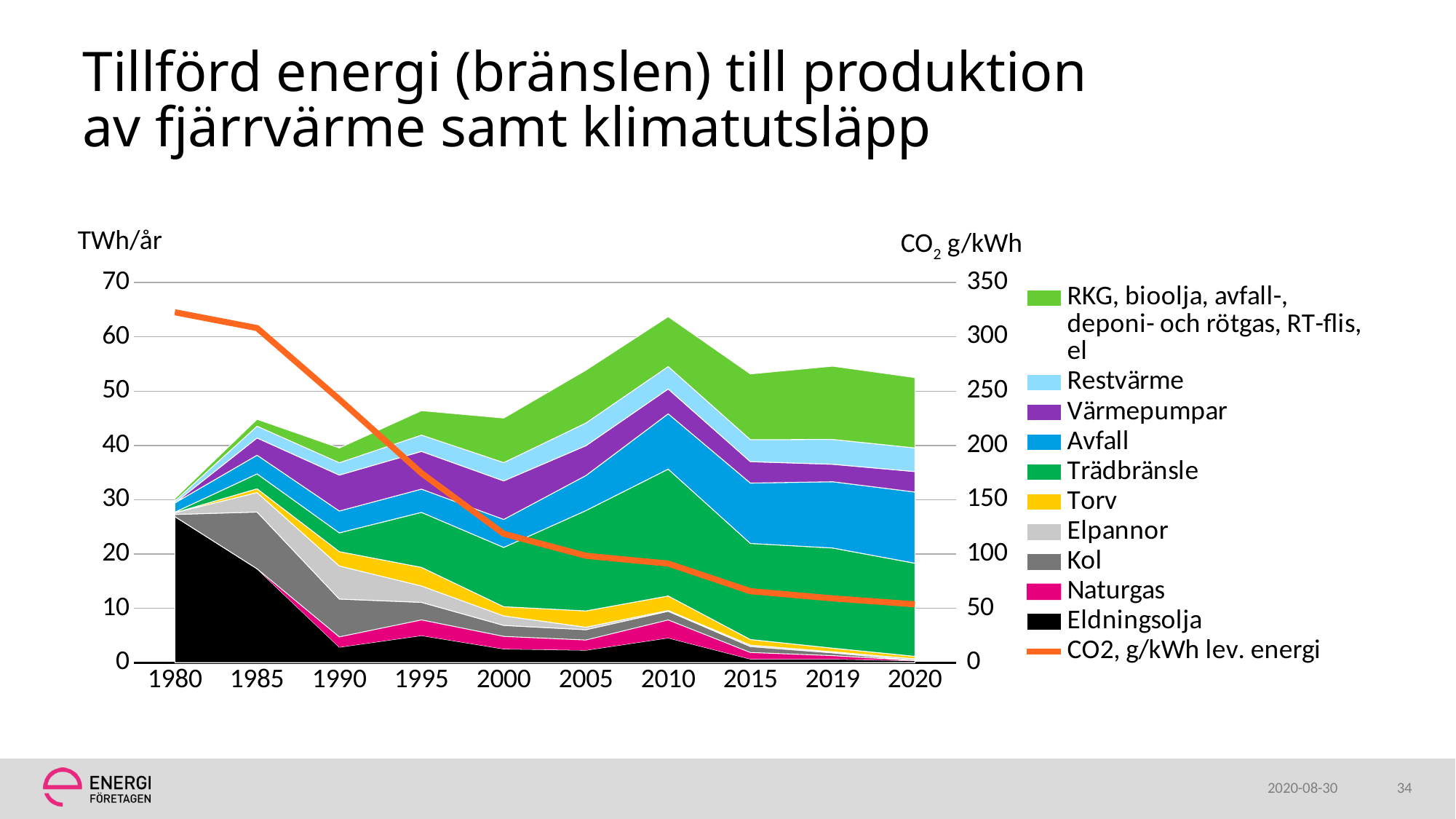
Which series is plotted as a line rather than a stacked area? CO2, g/kWh lev. energi Is the CO2, g/kWh lev. energi value in 2010 greater or less than 100? less Is the total tillförd energi (top of the stacked areas) in 1980 greater or less than 40 TWh/år? less What kind of chart is shown on the slide? Stacked area chart with a line How many series does the chart's legend list? 11 Does the CO2, g/kWh lev. energi line rise or fall from 1980 to 2020? Fall How many years are shown along the x axis of the chart? 10 Is the total tillförd energi (top of the stacked areas) in 2010 greater or less than 60 TWh/år? greater In which year is the total tillförd energi (top of the stacked areas) highest? 2010